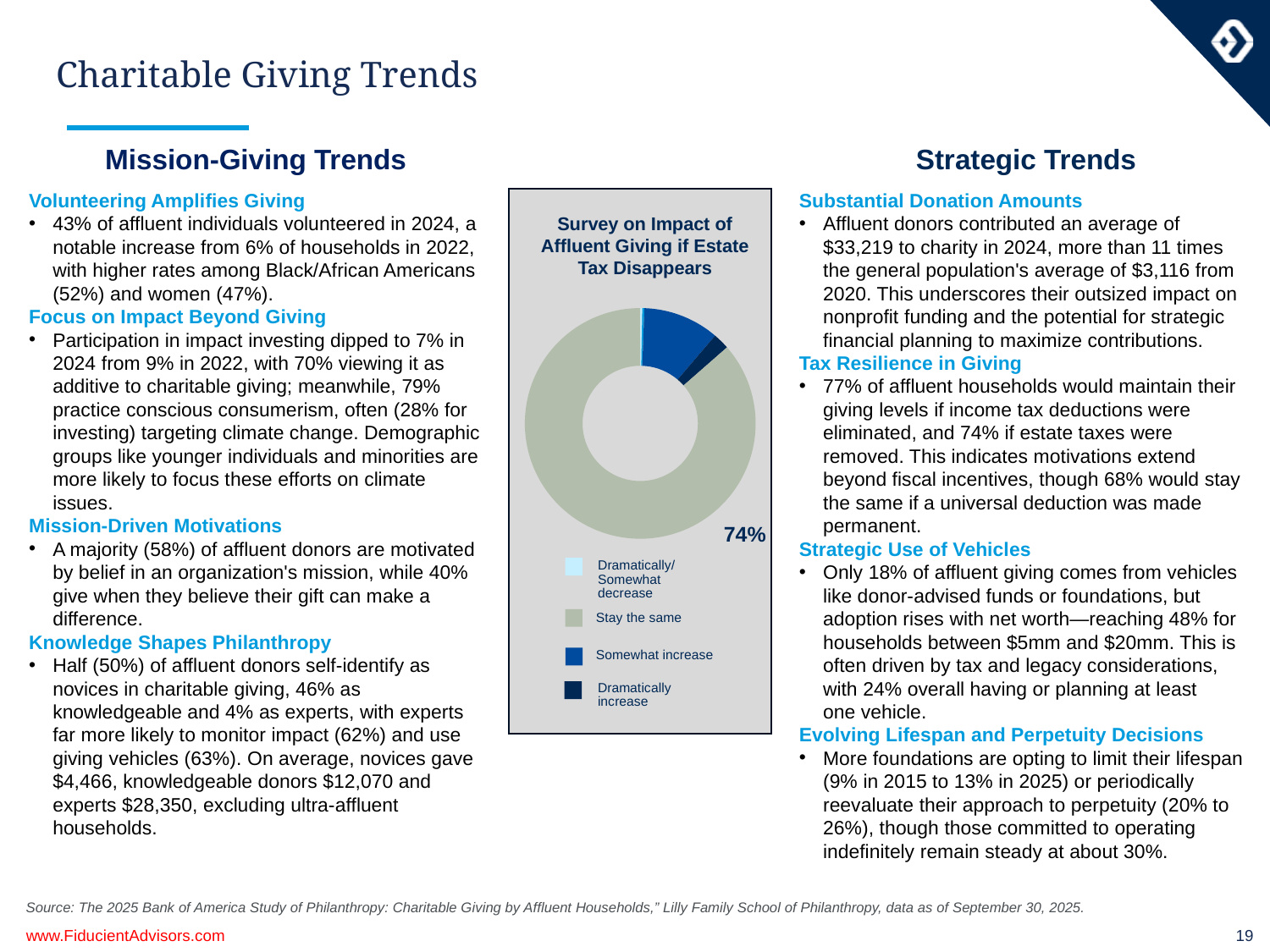
Which slice is larger: 'Dramatically increase' or 'Somewhat increase'? Somewhat increase How many response categories does the chart's legend list? 4 Which slice is larger: 'Stay the same' or 'Dramatically increase'? Stay the same Which response category has the largest slice of the pie? Stay the same What is the title of the chart? Survey on Impact of Affluent Giving if Estate Tax Disappears Is the value for 'Stay the same' greater or less than 50%? greater What percentage of affluent donors say their giving would stay the same if the estate tax disappears? 74% What share of the pie does the 'Stay the same' slice represent? 74% What kind of chart is shown on the slide? Doughnut (donut) chart Which legend entry is shown in the lightest blue colour? Dramatically/Somewhat decrease Which response category has the smallest slice of the pie? Dramatically/Somewhat decrease